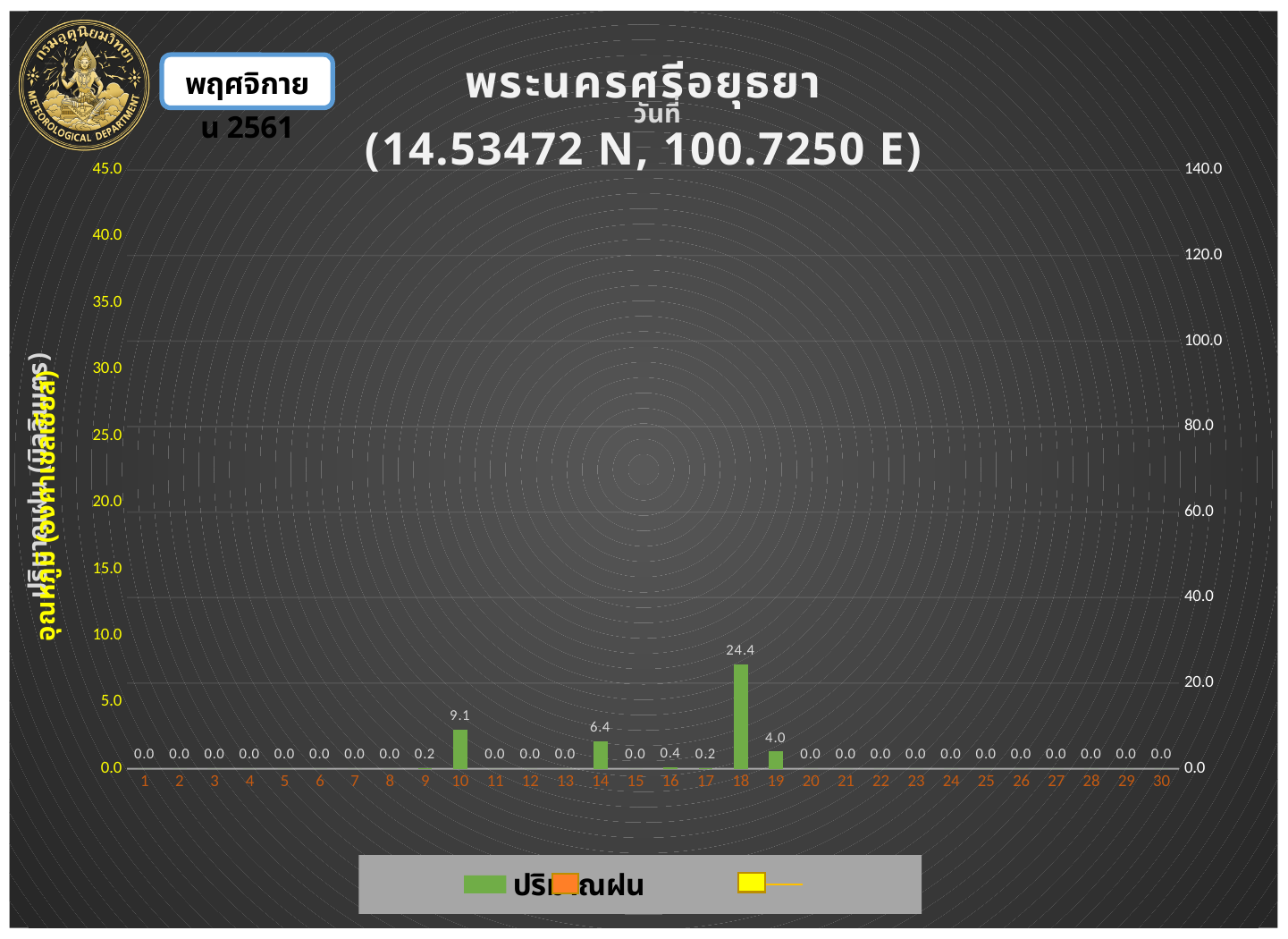
What is the difference between the rainfall values for day 18 and day 10? 15.3 Which day has the highest rainfall value? 18 What is the rainfall value shown for day 14? 6.4 How many days are shown on the x axis of the chart? 30 What is the rainfall value shown for day 19? 4.0 What kind of chart is shown on the slide? bar chart What is the rainfall value shown for day 18? 24.4 Which day has the larger rainfall value, day 10 or day 14? 10 What are the coordinates given in the chart title? 14.53472 N, 100.7250 E What is the rainfall value shown for day 9? 0.2 What is the rainfall value shown for day 10? 9.1 What is the rainfall value shown for day 16? 0.4